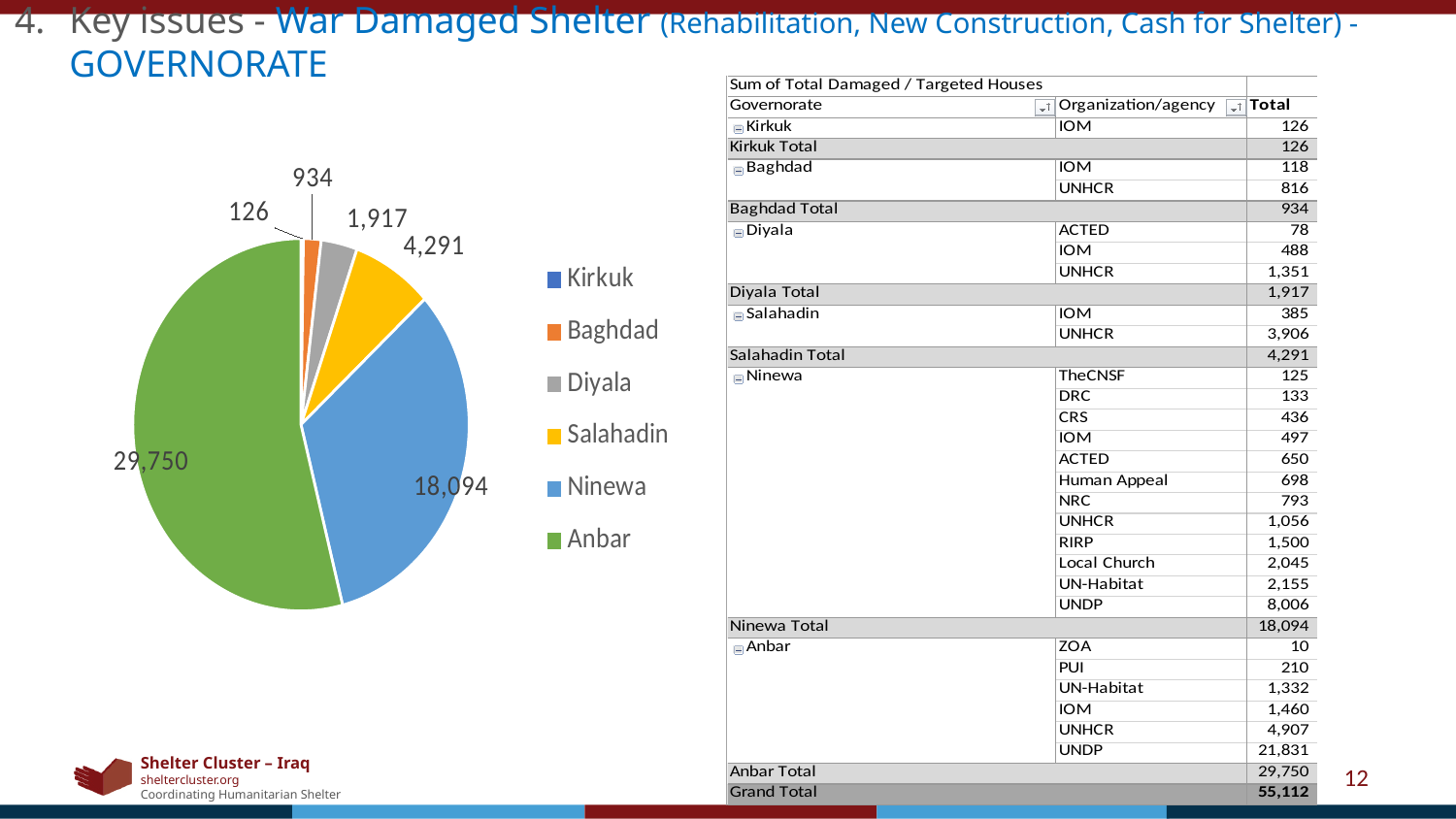
What type of chart is shown on the slide? pie chart What is the value for Anbar in the pie chart? 29,750 What is the value for Ninewa in the pie chart? 18,094 What is the value for Baghdad in the pie chart? 934 What colour is the Anbar slice in the pie chart? green Which governorate has the smallest slice in the pie chart? Kirkuk What is the value for Salahadin in the pie chart? 4,291 What is the value for Diyala in the pie chart? 1,917 How many governorates are listed in the pie chart legend? 6 Which governorate has the largest slice in the pie chart? Anbar What is the difference between the values for Anbar and Ninewa in the pie chart? 11,656 Which is larger in the pie chart, the value for Diyala or the value for Baghdad? Diyala